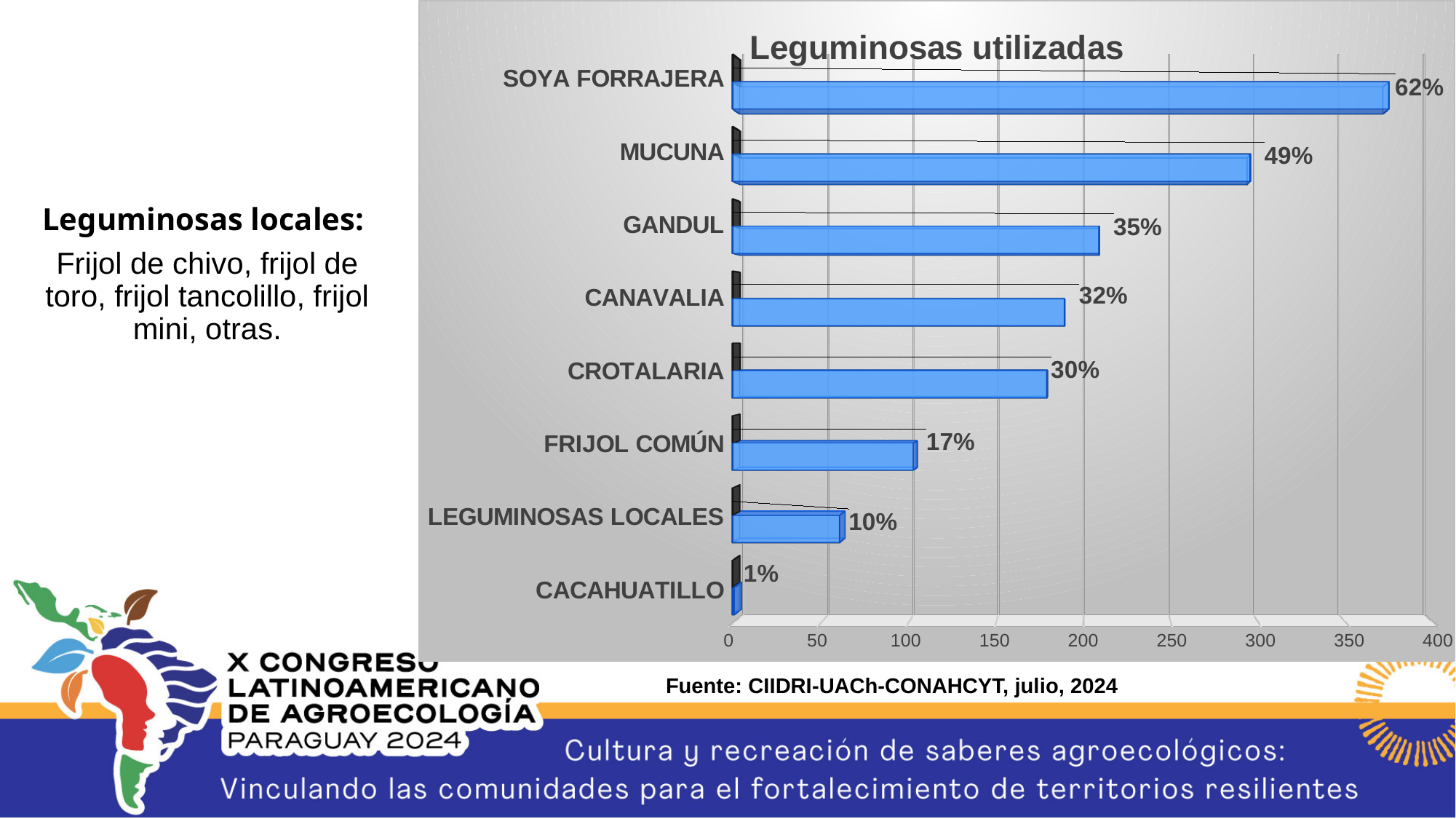
What percentage label is shown for CROTALARIA? 30% Which category has the highest value? SOYA FORRAJERA What percentage label is shown for LEGUMINOSAS LOCALES? 10% Which category has the lowest value? CACAHUATILLO Which is larger, the value for FRIJOL COMÚN or the value for CROTALARIA? CROTALARIA What percentage label is shown for SOYA FORRAJERA? 62% Is the bar for MUCUNA greater or less than 250 on the x axis? greater What type of chart is shown on the slide? bar chart What percentage label is shown for MUCUNA? 49% How many categories are plotted in the chart? 8 What is the difference in percentage points between GANDUL and CANAVALIA? 3% What is the title of the chart? Leguminosas utilizadas